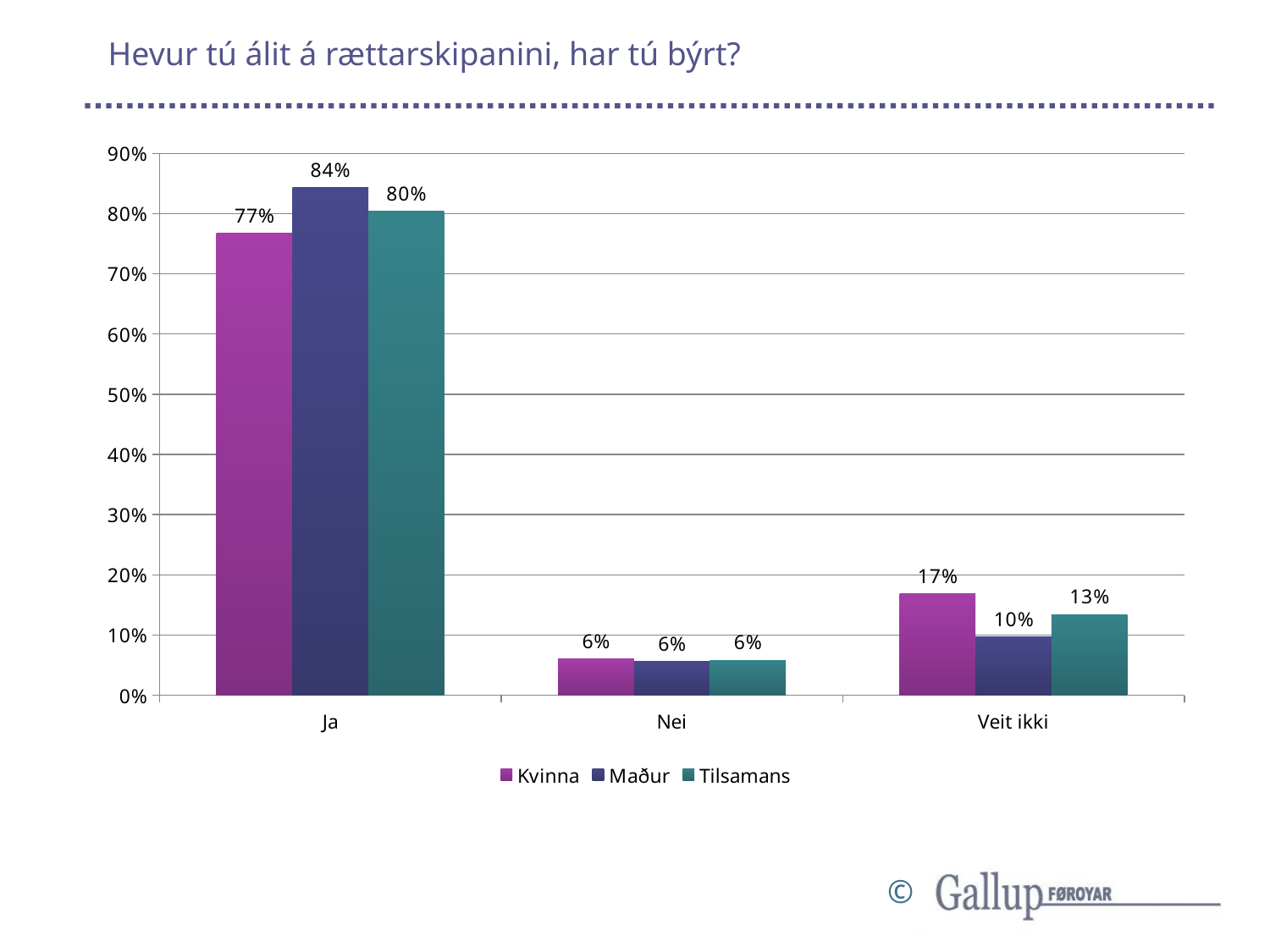
Which is larger in the Veit ikki category, Kvinna or Maður? Kvinna How many series does the legend list? 3 What is the title of the chart? Hevur tú álit á rættarskipanini, har tú býrt? What is the difference between the Maður and Kvinna values in the Ja category? 7% How many categories are shown on the x axis? 3 What is the value for Maður in the Ja category? 84% Is the value for Kvinna in the Ja category greater or less than 70%? greater Which category has the lowest value for Maður? Nei What kind of chart is shown on the slide? bar chart What is the value for Kvinna in the Veit ikki category? 17% Which category has the highest value for Tilsamans? Ja What is the value for Tilsamans in the Nei category? 6%